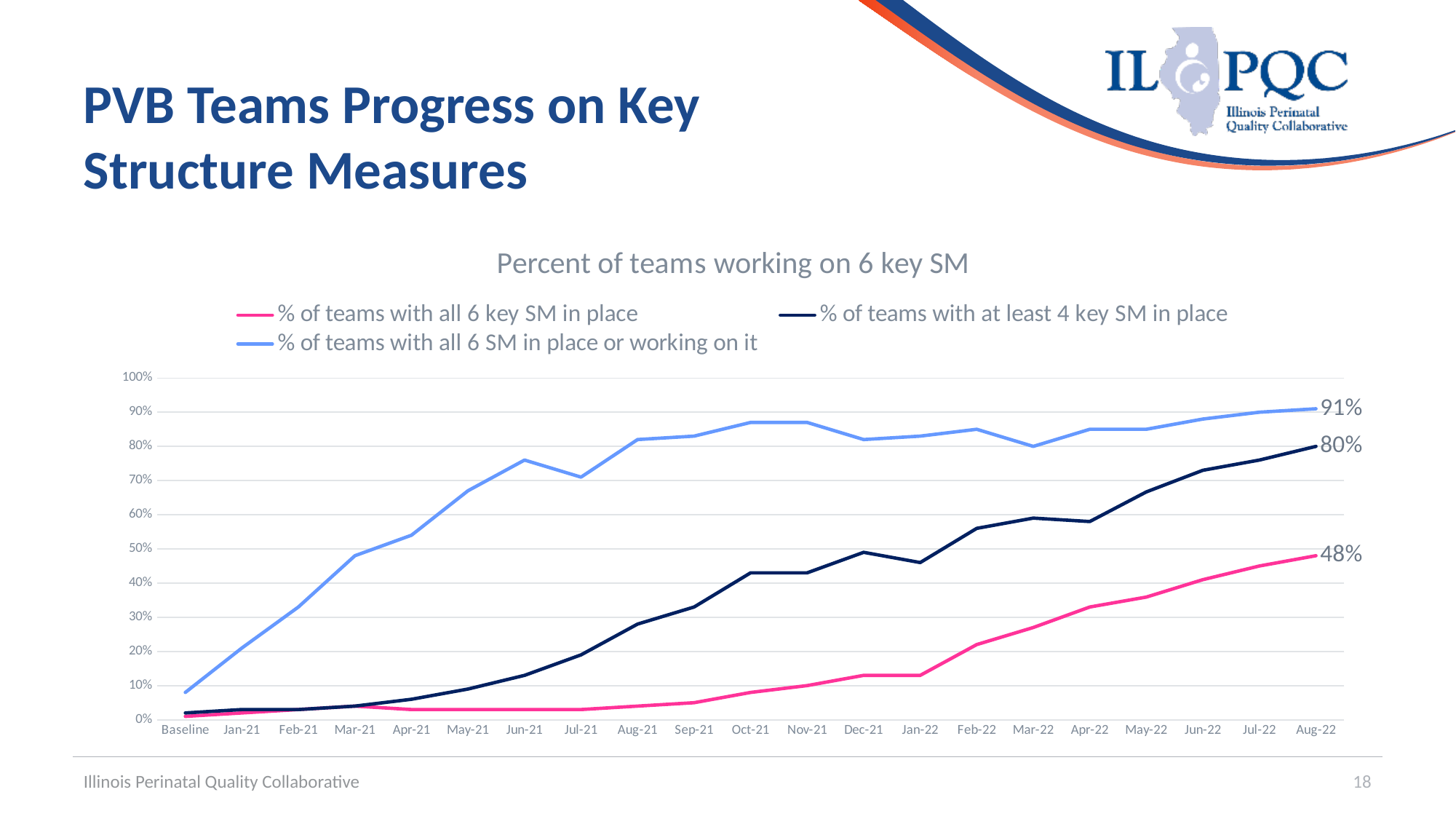
Is the value for '% of teams with all 6 SM in place or working on it' at Jun-21 greater or less than 70%? greater What is the title of the chart? Percent of teams working on 6 key SM What type of chart is shown on the slide? line chart At Aug-22, what is the difference between '% of teams with all 6 SM in place or working on it' and '% of teams with all 6 key SM in place'? 43 percentage points Does the '% of teams with all 6 key SM in place' series generally rise or fall from Baseline to Aug-22? rise How many time points are shown on the x axis? 21 What is the value for '% of teams with at least 4 key SM in place' at Aug-22? 80% What is the value for '% of teams with all 6 SM in place or working on it' at Aug-22? 91% How many series does the legend list? 3 Which series has the highest value at Aug-22? % of teams with all 6 SM in place or working on it At Aug-22, what is the difference between '% of teams with at least 4 key SM in place' and '% of teams with all 6 key SM in place'? 32 percentage points What is the value for '% of teams with all 6 key SM in place' at Aug-22? 48%